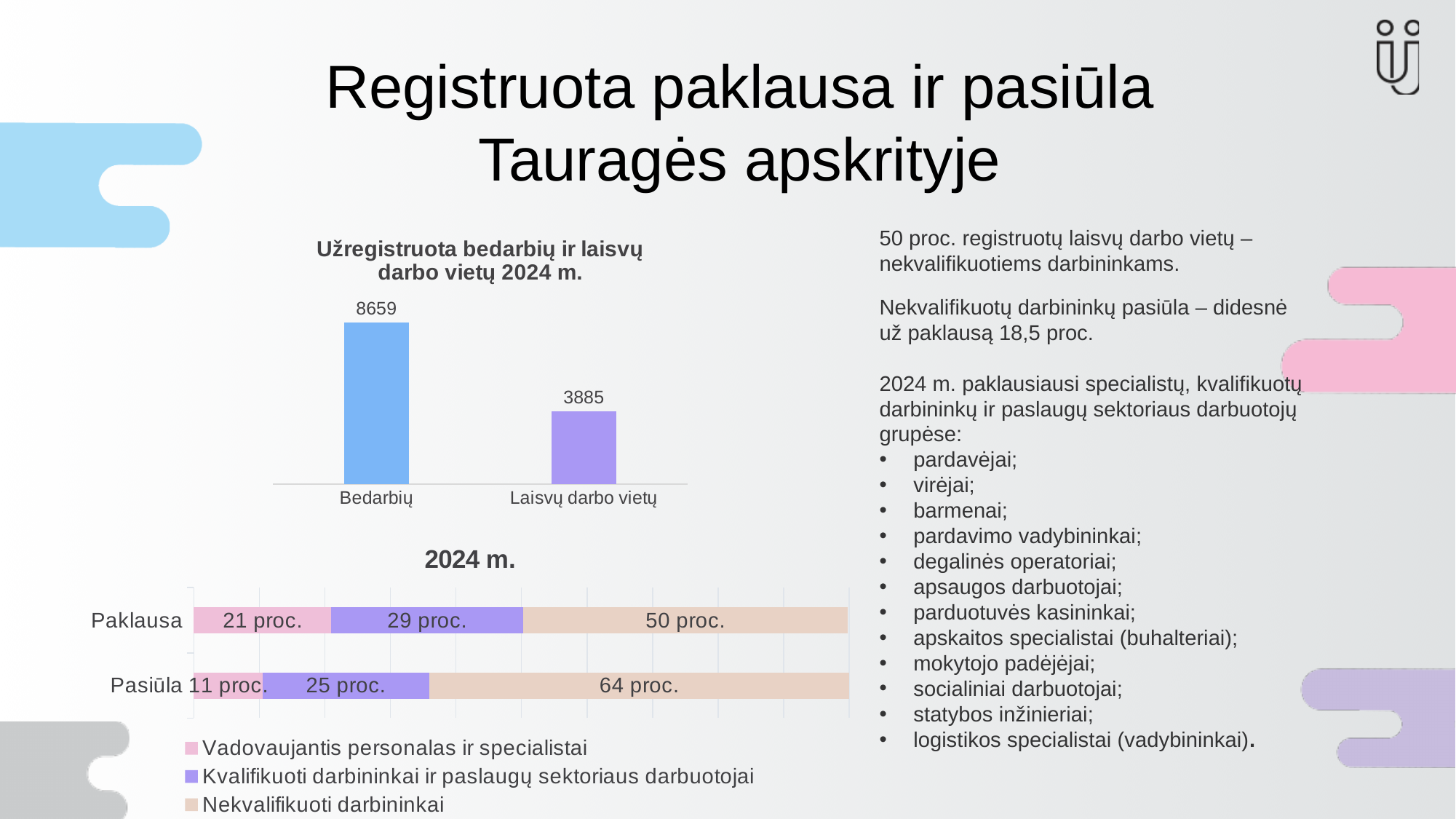
In the chart titled "2024 m.", what is the difference between the Kvalifikuoti darbininkai ir paslaugų sektoriaus darbuotojai values for Paklausa and Pasiūla? 4 proc. In the chart titled "2024 m.", what is the value of Vadovaujantis personalas ir specialistai for Pasiūla? 11 proc. In the chart titled "Užregistruota bedarbių ir laisvų darbo vietų 2024 m.", which category has the higher value? Bedarbių How many series does the legend of the chart titled "2024 m." list? 3 In the chart titled "2024 m.", what is the value of Kvalifikuoti darbininkai ir paslaugų sektoriaus darbuotojai for Paklausa? 29 proc. In the chart titled "2024 m.", what is the value of Nekvalifikuoti darbininkai for Paklausa? 50 proc. In the chart titled "Užregistruota bedarbių ir laisvų darbo vietų 2024 m.", what is the value for Laisvų darbo vietų? 3885 In the chart titled "Užregistruota bedarbių ir laisvų darbo vietų 2024 m.", how many categories are shown? 2 In the chart titled "Užregistruota bedarbių ir laisvų darbo vietų 2024 m.", what is the difference between Bedarbių and Laisvų darbo vietų? 4774 In the chart titled "2024 m.", which is larger: Nekvalifikuoti darbininkai for Paklausa or for Pasiūla? Pasiūla In the chart titled "Užregistruota bedarbių ir laisvų darbo vietų 2024 m.", what is the value for Bedarbių? 8659 What kind of chart is the chart titled "2024 m." at the bottom left of the slide? Stacked bar chart